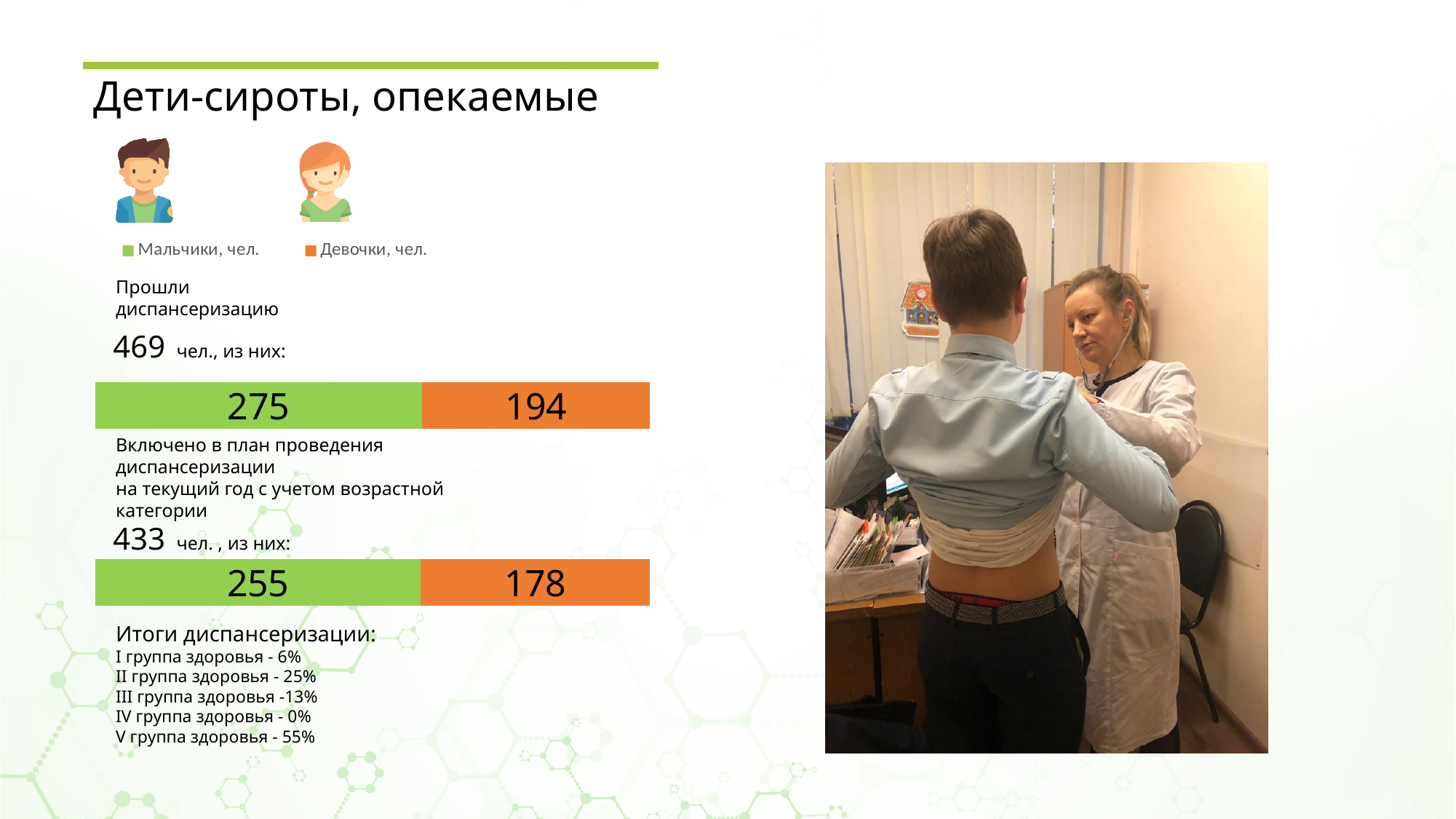
Which colour represents Девочки in the bars? Orange In the upper bar (Прошли диспансеризацию), what is the difference between Мальчики and Девочки? 81 In the upper bar (Прошли диспансеризацию), which is larger, Мальчики or Девочки? Мальчики In the upper bar (Прошли диспансеризацию), what is the value for Мальчики? 275 What is the total of the lower stacked bar (Включено в план проведения диспансеризации)? 433 In the lower bar (Включено в план проведения диспансеризации), what is the value for Мальчики? 255 How many series does the legend list for the bars? 2 In the lower bar (Включено в план проведения диспансеризации), what is the value for Девочки? 178 In the upper bar (Прошли диспансеризацию), what is the value for Девочки? 194 What is the total of the upper stacked bar (Прошли диспансеризацию)? 469 In the lower bar (Включено в план проведения диспансеризации), what is the difference between Мальчики and Девочки? 77 What kind of chart is used to show the boys and girls figures? Stacked bar chart